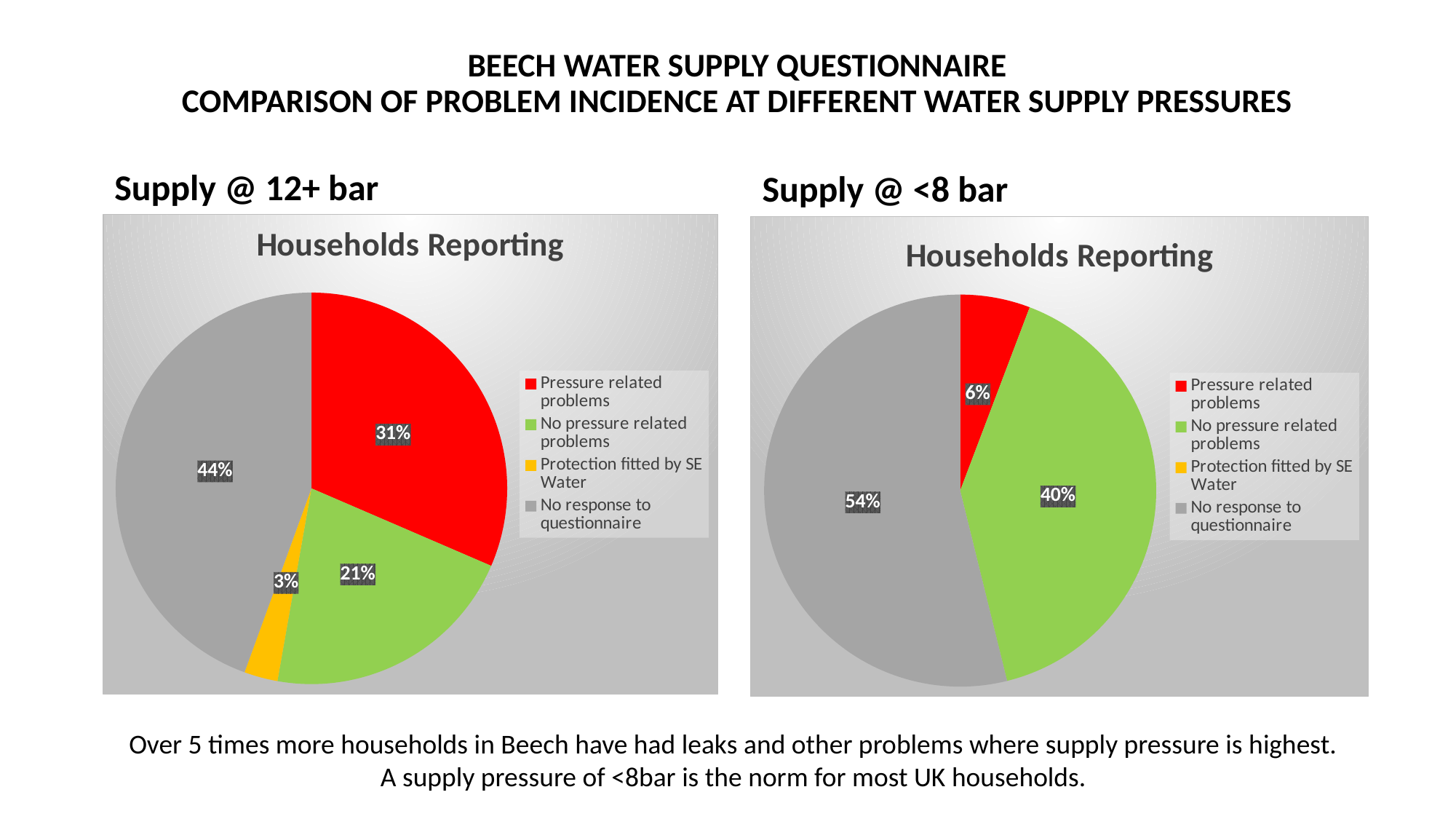
In the right chart (Supply @ <8 bar), which category has the largest slice? No response to questionnaire Which chart shows a larger share for 'No pressure related problems', the left (12+ bar) or the right (<8 bar)? The right chart (Supply @ <8 bar) In the right chart (Supply @ <8 bar), what percentage is shown for 'No response to questionnaire'? 54% In the left chart (Supply @ 12+ bar), which category has the largest slice? No response to questionnaire What is the difference between the 'Pressure related problems' share in the left chart (12+ bar) and in the right chart (<8 bar)? 25% What type of chart is used on this slide? Pie chart What colour represents 'Pressure related problems' in both charts? Red How many entries does the legend of the left chart (Supply @ 12+ bar) list? 4 In the left chart (Supply @ 12+ bar), which category has the smallest slice? Protection fitted by SE Water In the right chart (Supply @ <8 bar), what share of households reported pressure related problems? 6% In the left chart (Supply @ 12+ bar), what percentage is shown for 'Protection fitted by SE Water'? 3% In the left chart (Supply @ 12+ bar), what share of households reported pressure related problems? 31%